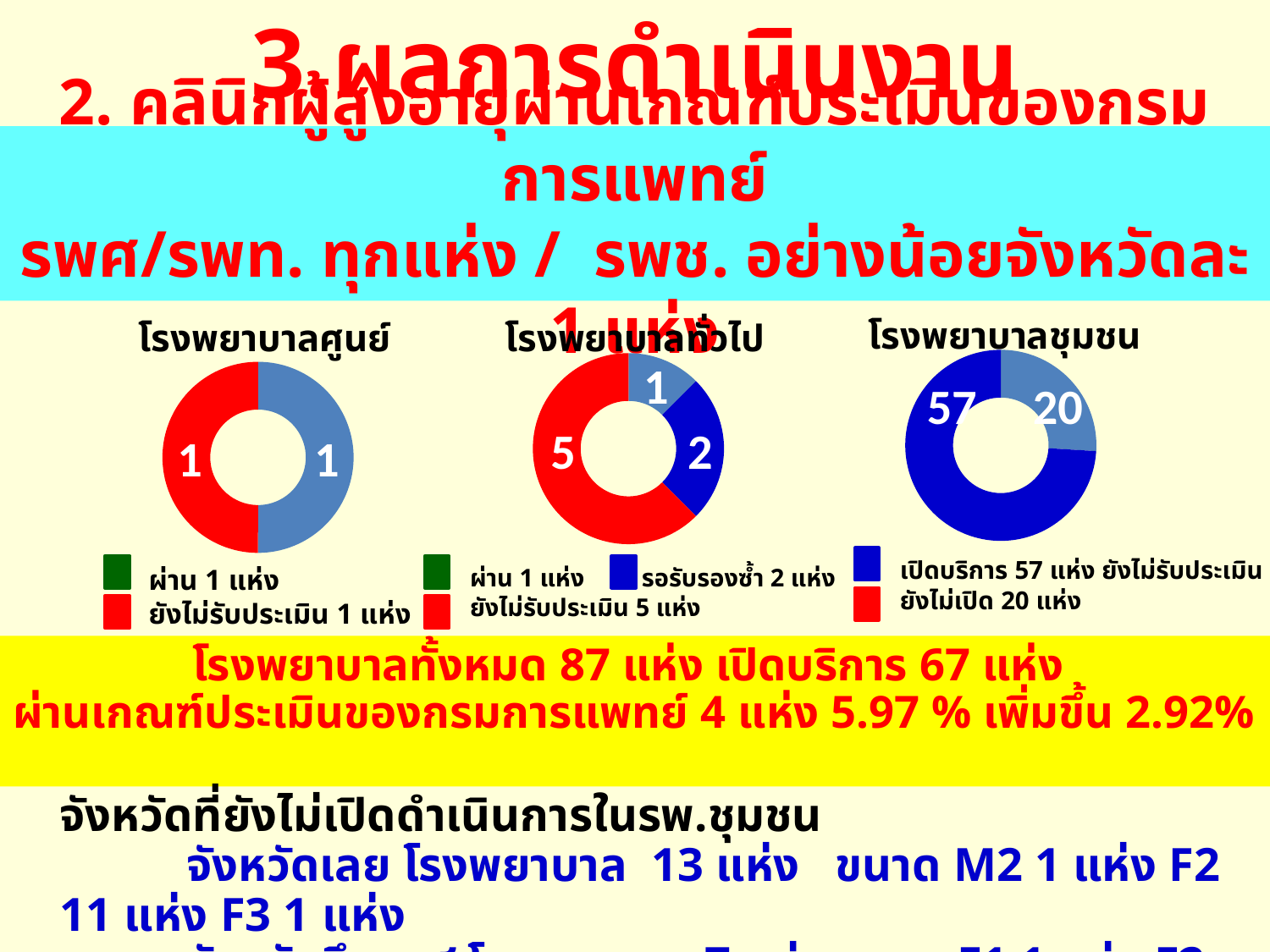
In the โรงพยาบาลชุมชน chart, what is the difference between เปิดบริการ and ยังไม่เปิด? 37 In the โรงพยาบาลทั่วไป chart, which category has the smallest value? ผ่าน In the โรงพยาบาลทั่วไป chart, which category has the largest value? ยังไม่รับประเมิน What is the total of all segments in the โรงพยาบาลชุมชน chart? 77 In the โรงพยาบาลทั่วไป chart, what is the value for ยังไม่รับประเมิน? 5 In the โรงพยาบาลชุมชน chart, what is the value for เปิดบริการ? 57 What is the total of all segments in the โรงพยาบาลทั่วไป chart? 8 How many segments does the โรงพยาบาลทั่วไป chart have? 3 In the โรงพยาบาลศูนย์ chart, what share of the total does ผ่าน represent? 50% What kind of chart is used for โรงพยาบาลชุมชน? doughnut chart In the โรงพยาบาลชุมชน chart, which is larger: เปิดบริการ or ยังไม่เปิด? เปิดบริการ In the โรงพยาบาลทั่วไป chart, what is the value for รอรับรองซ้ำ? 2